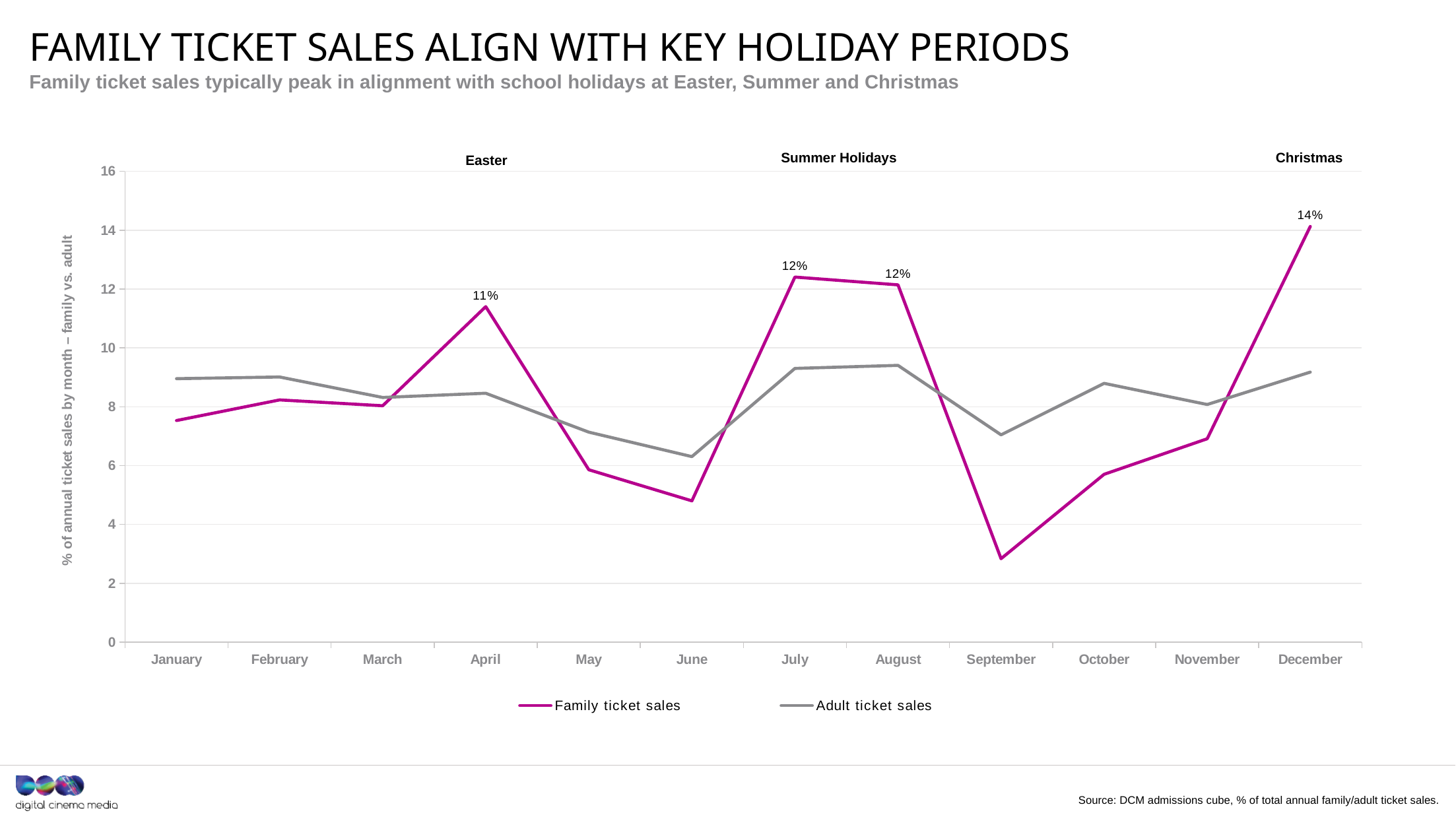
How many months are shown on the x axis? 12 Is the value for Adult ticket sales in July greater or less than 8? greater What is the value for Family ticket sales in December? 14% In which month are Family ticket sales lowest? September In which month are Family ticket sales highest? December How many series does the legend list? 2 What is the value for Family ticket sales in April? 11% What is the value for Family ticket sales in July? 12% Which series has the larger value in December, Family ticket sales or Adult ticket sales? Family ticket sales Is the value for Family ticket sales in September greater or less than 4? less Which series has the larger value in September, Family ticket sales or Adult ticket sales? Adult ticket sales What kind of chart is shown on the slide? Line chart